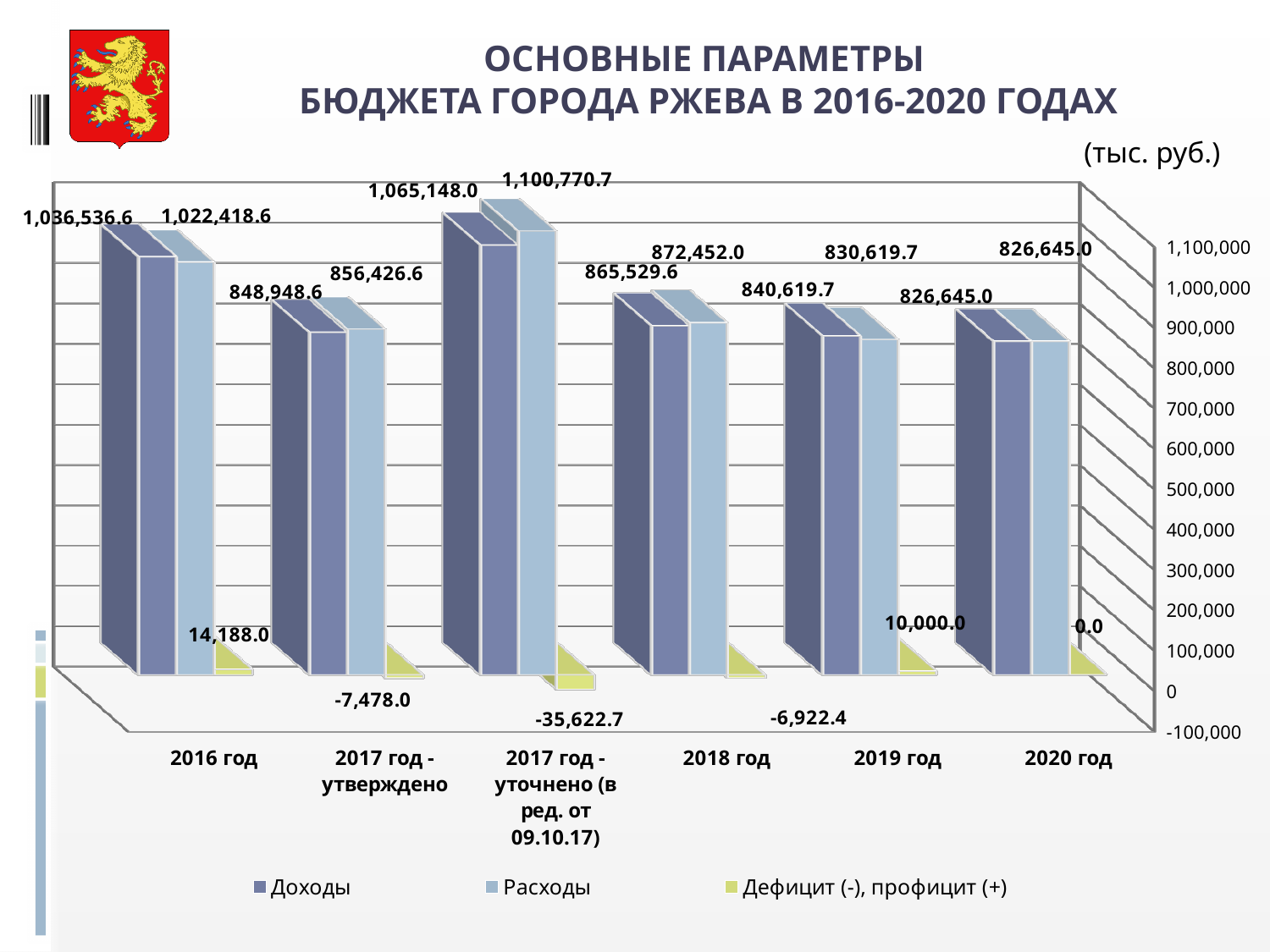
What is the difference between Доходы and Расходы for 2019 год? 10,000.0 What type of chart is shown on the slide? Bar chart Which is larger for 2017 год - утверждено: Доходы or Расходы? Расходы What is the value of Доходы for 2016 год? 1,036,536.6 Which category has the highest value of Расходы? 2017 год - уточнено (в ред. от 09.10.17) How many series does the legend list? 3 What is the value of Расходы for 2017 год - уточнено (в ред. от 09.10.17)? 1,100,770.7 How many categories are shown on the x axis? 6 What unit is indicated for the values on the chart? тыс. руб. Which category has the lowest value of Дефицит (-), профицит (+)? 2017 год - уточнено (в ред. от 09.10.17) What is the value of Расходы for 2018 год? 872,452.0 What is the value of Дефицит (-), профицит (+) for 2019 год? 10,000.0